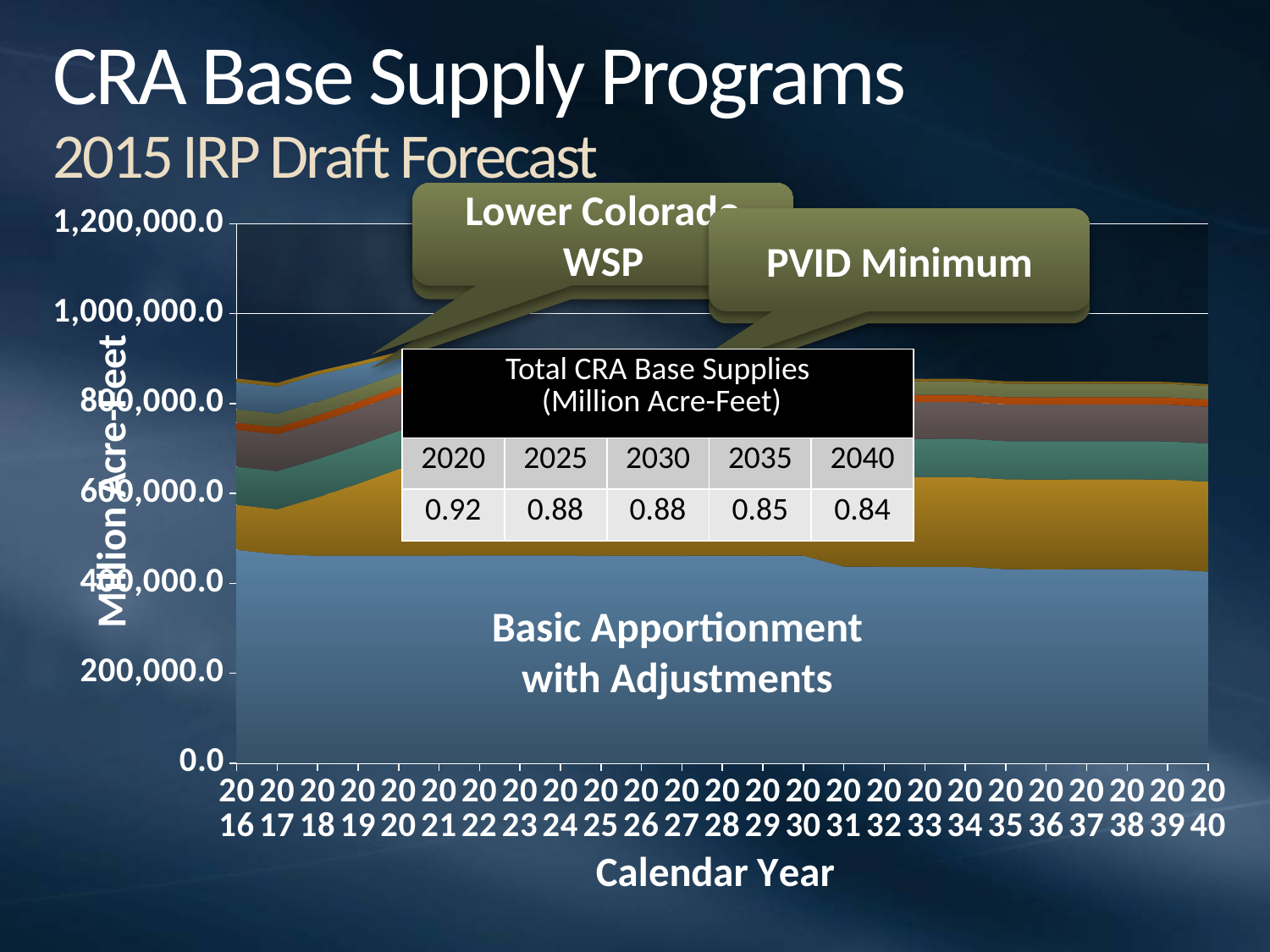
Is the value of the Basic Apportionment with Adjustments layer in 2016 greater or less than 600,000.0? less According to the Total CRA Base Supplies table, which year has the lowest total? 2040 Is the total stacked value of all layers in 2016 greater or less than 1,000,000.0? less According to the Total CRA Base Supplies table on the chart, what is the total for 2040? 0.84 How many calendar years are shown along the x axis of the chart? 25 Do the Total CRA Base Supplies values in the table rise or fall from 2020 to 2040? fall According to the Total CRA Base Supplies table, which year has the highest total? 2020 What is the title of the x axis of the chart? Calendar Year According to the Total CRA Base Supplies table on the chart, what is the total for 2020? 0.92 What is the title of the y axis of the chart? Million Acre-Feet What is the difference between the Total CRA Base Supplies values for 2020 and 2035? 0.07 What kind of chart is shown on the slide? area chart